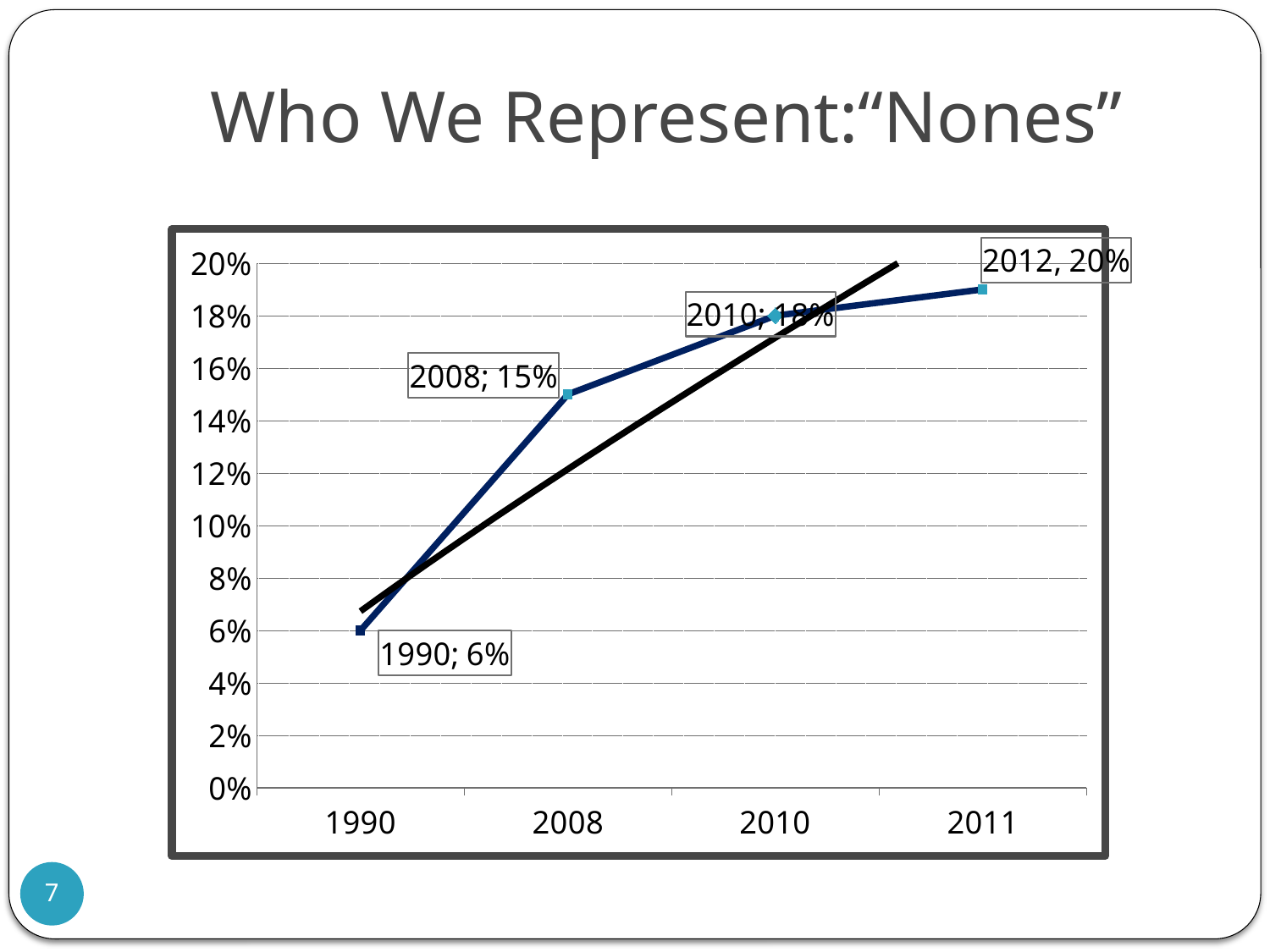
Which year has the lowest value? 1990 What kind of chart is shown on the slide? line chart What is the difference between the values for 2010 and 2008? 3% What is the difference between the values for 2008 and 1990? 9% Do the values rise or fall from 1990 to 2011? rise What is the value for 2008? 15% What is the value for 2010? 18% Is the value for 2011 greater or less than 18%? greater What is the value for 1990? 6% Which is larger, the value for 2008 or the value for 2010? 2010 Is the value for 1990 greater or less than 10%? less How many years are shown on the x axis? 4